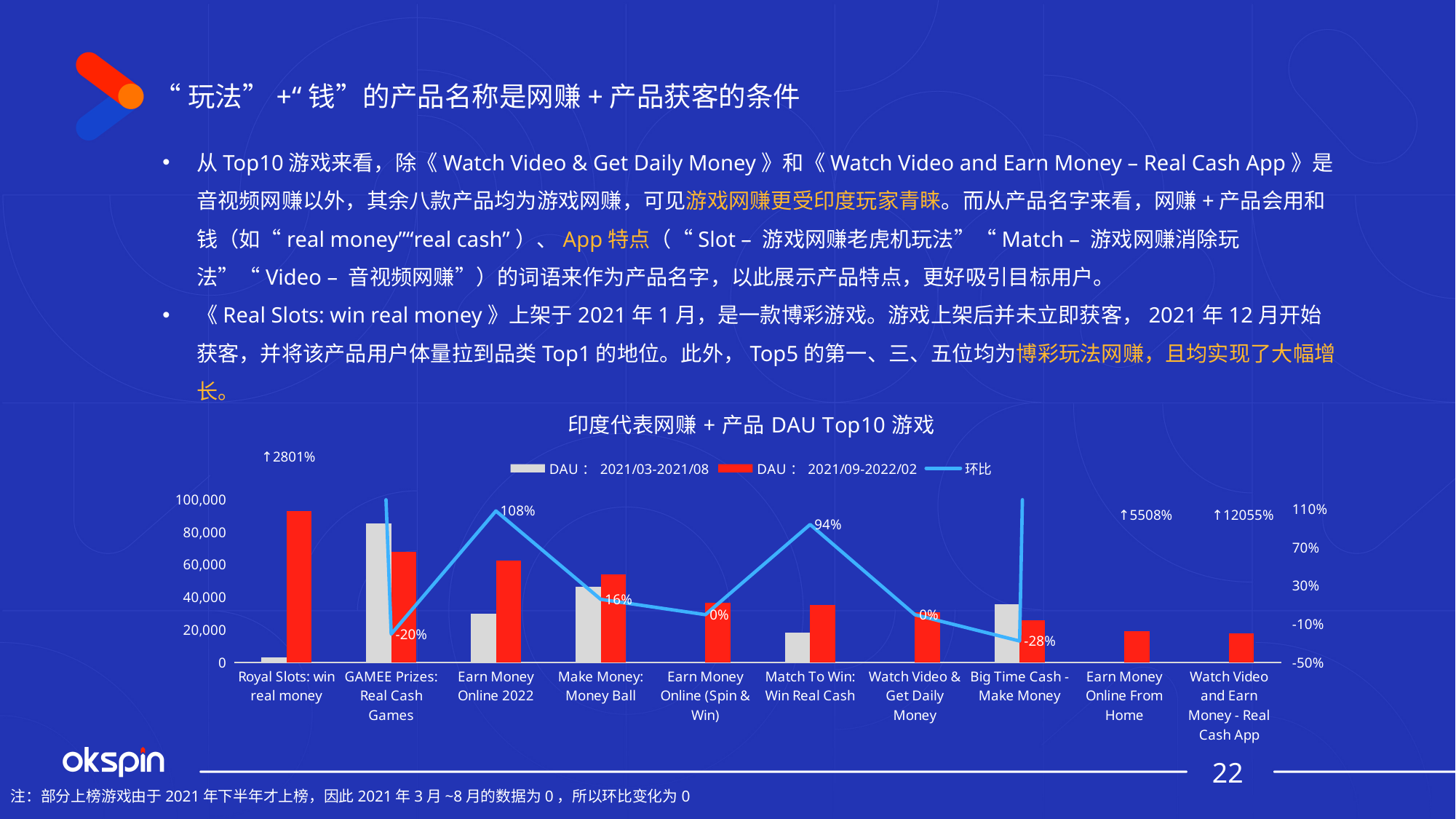
What is the 环比 value labelled for Big Time Cash - Make Money? -28% For GAMEE Prizes: Real Cash Games, which DAU bar is larger, 2021/03-2021/08 or 2021/09-2022/02? 2021/03-2021/08 What is the 环比 value labelled for Royal Slots: win real money? ↑2801% How many series does the chart's legend list? 3 Which game has the lowest labelled 环比 value? Big Time Cash - Make Money What is the difference between the 环比 values labelled for Earn Money Online 2022 and Match To Win: Win Real Cash? 14 percentage points How many games (categories) are shown on the x axis of the chart? 10 Which game has the highest labelled 环比 value? Watch Video and Earn Money - Real Cash App Is the DAU 2021/09-2022/02 value for Royal Slots: win real money greater or less than 80,000? greater What kind of chart is shown on the slide? Bar chart combined with a line What is the title of the chart on the slide? 印度代表网赚 + 产品 DAU Top10 游戏 What is the 环比 value labelled for Earn Money Online 2022? 108%